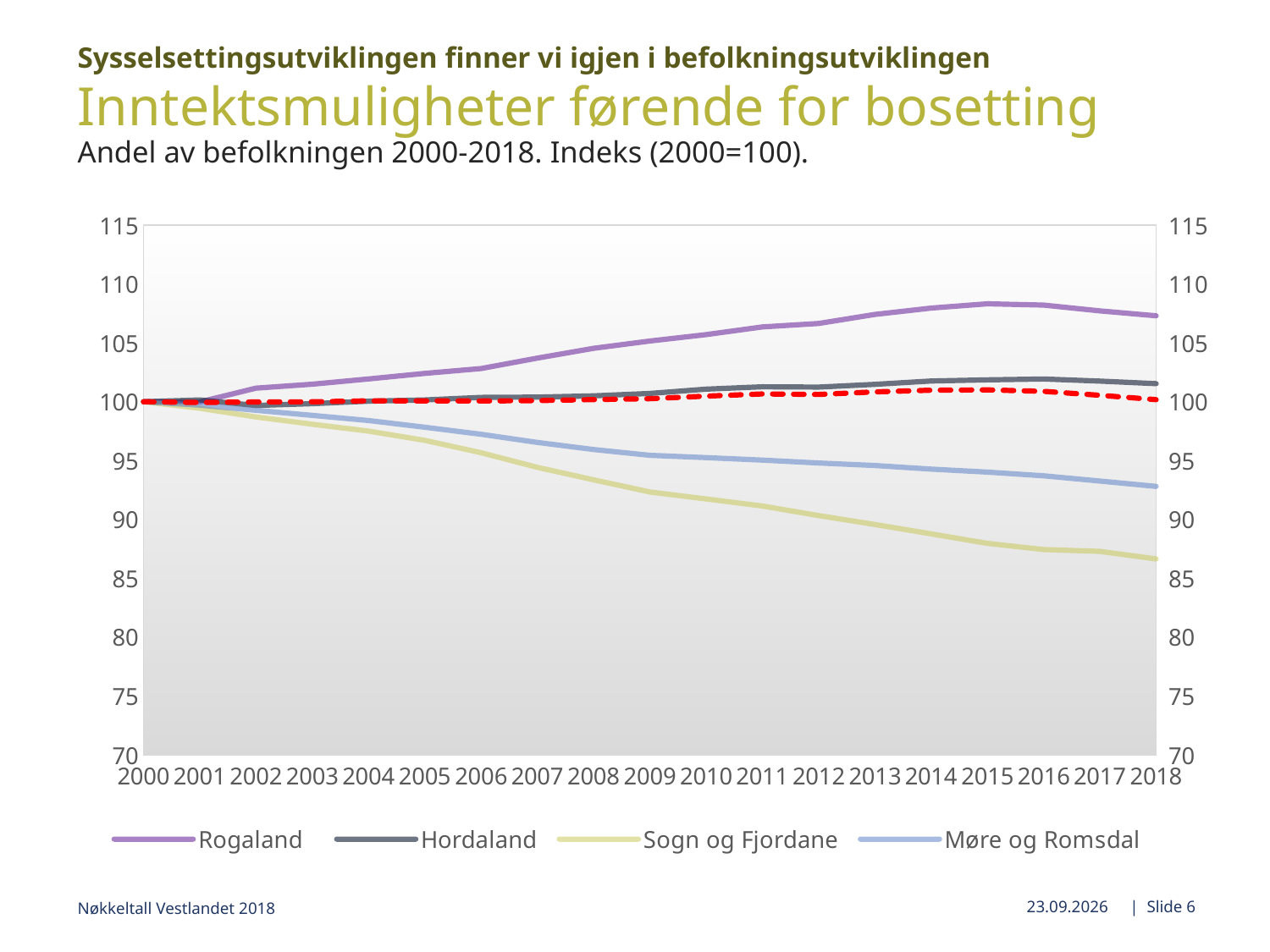
What kind of chart is shown on the slide? line chart Does the Rogaland line rise or fall from 2000 to 2018? rise What is the index value for all series in 2000? 100 Which is larger in 2010, the value for Rogaland or the value for Hordaland? Rogaland How many years are shown along the x axis? 19 Does the Sogn og Fjordane line rise or fall from 2000 to 2018? fall Is the value for Møre og Romsdal in 2018 greater or less than 95? less How many series does the legend list? 4 Which series has the lowest value in 2018? Sogn og Fjordane Is the value for Rogaland in 2015 greater or less than 105? greater Which series has the highest value in 2018? Rogaland Is the value for Sogn og Fjordane in 2018 greater or less than 90? less